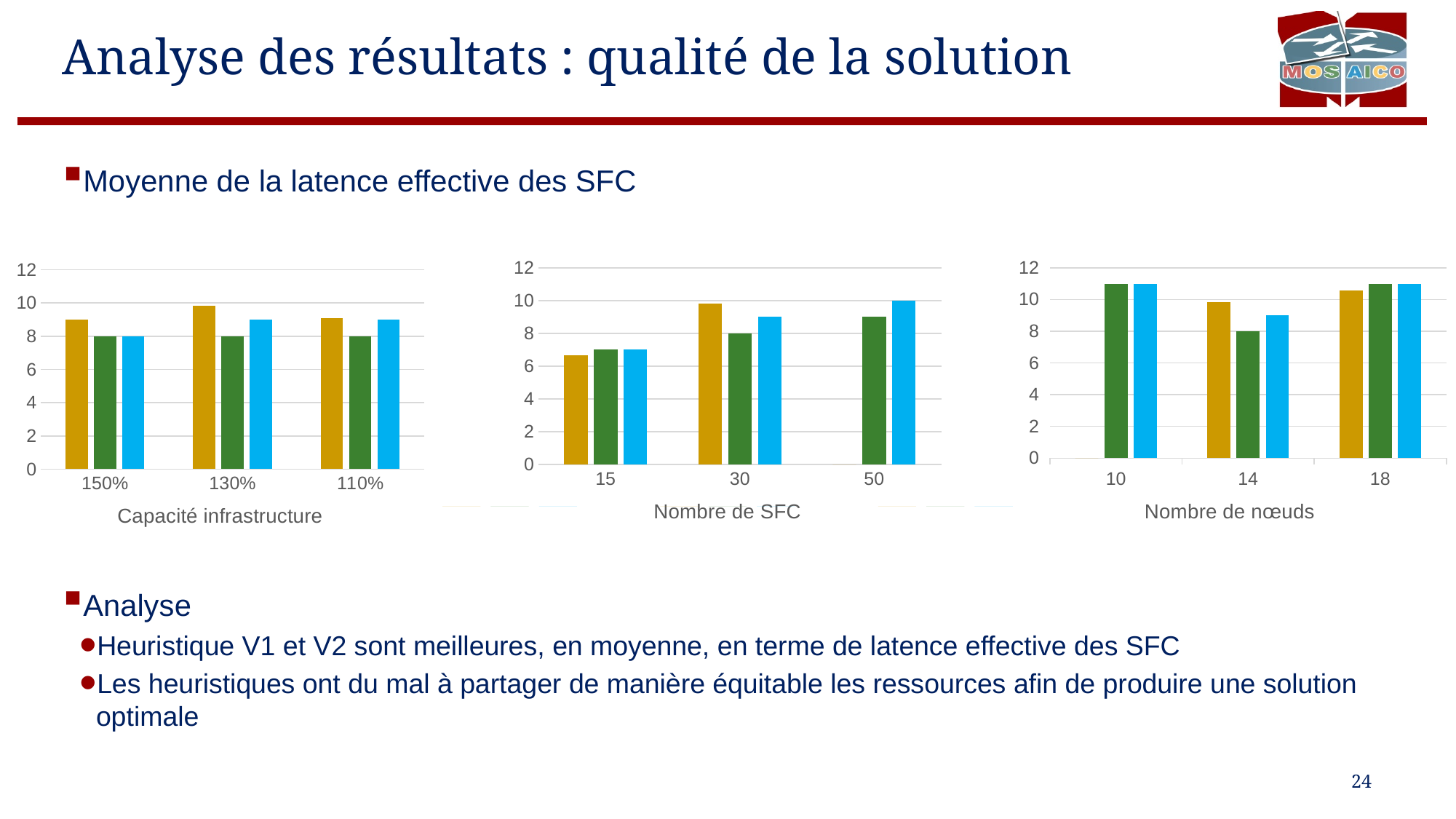
In the 'Capacité infrastructure' chart, is the gold bar for 130% greater or less than 8? greater In the 'Nombre de SFC' chart, at which category is the blue bar highest? 50 In the 'Nombre de SFC' chart, at which category is the green bar lowest? 15 How many categories are shown on the x axis of the 'Nombre de SFC' chart? 3 What is the x-axis label of the rightmost chart? Nombre de nœuds In the 'Nombre de nœuds' chart, is the green bar for 10 greater or less than 10? greater In the 'Nombre de SFC' chart, do the blue bars rise or fall as the number of SFC increases from 15 to 50? rise In the 'Nombre de nœuds' chart, is the green bar for 14 greater or less than 10? less In the 'Capacité infrastructure' chart, which is larger at 130%: the gold bar or the green bar? the gold bar What kind of chart is the 'Capacité infrastructure' chart? bar chart How many categories are shown on the x axis of the 'Nombre de nœuds' chart? 3